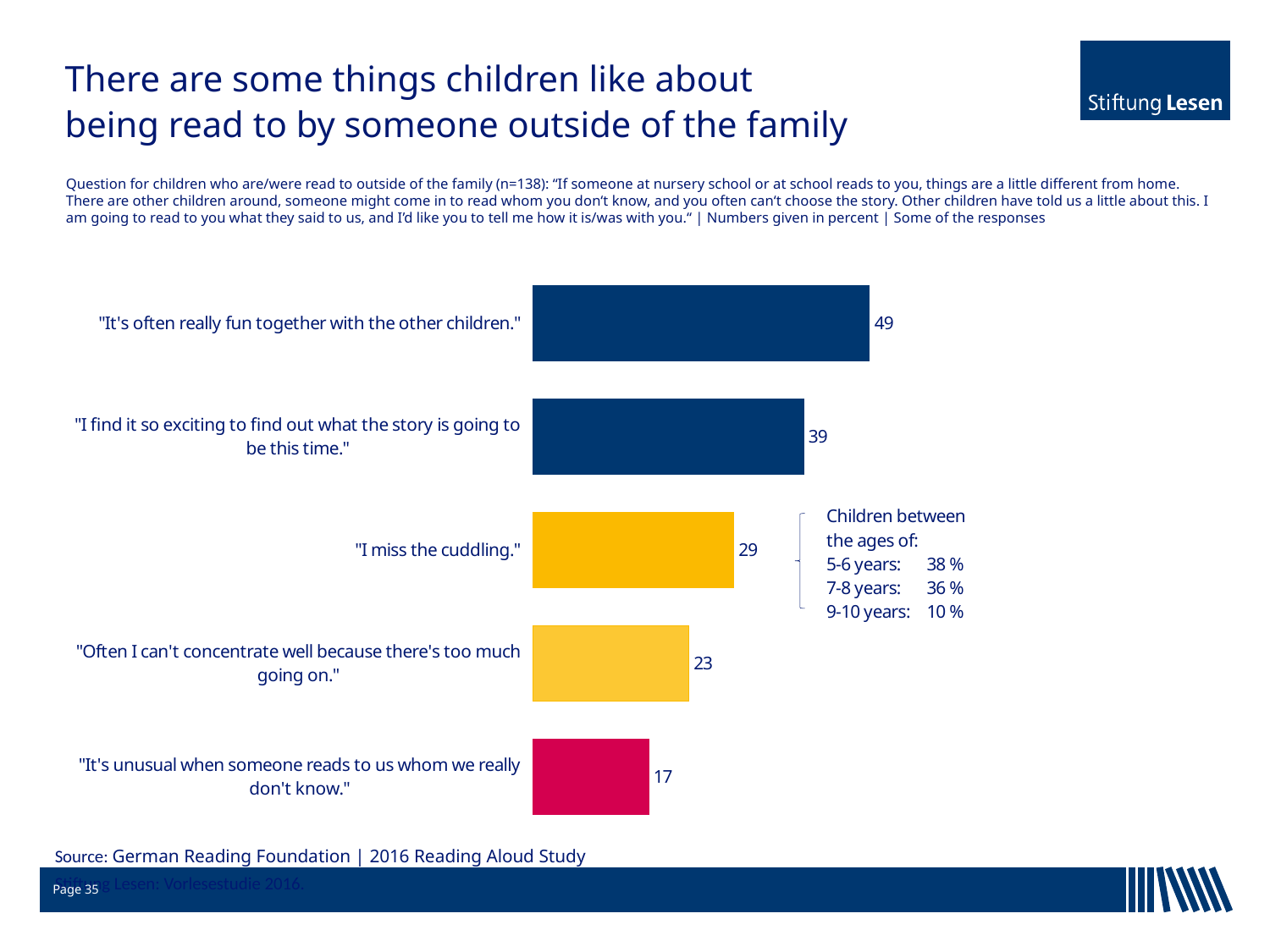
What percentage of children said "It's often really fun together with the other children."? 49 According to the annotation, what percentage of children aged 5-6 years said "I miss the cuddling."? 38 % What value is shown for "I miss the cuddling."? 29 According to the annotation, what percentage of children aged 9-10 years said "I miss the cuddling."? 10 % How many responses are shown in the chart? 5 Which response has the lowest value? "It's unusual when someone reads to us whom we really don't know." What kind of chart is shown on the slide? Bar chart Which response has the highest value? "It's often really fun together with the other children." Which is larger: the value for "I miss the cuddling." or the value for "Often I can't concentrate well because there's too much going on."? "I miss the cuddling." What colour is the bar for "It's unusual when someone reads to us whom we really don't know."? Red What value is shown for "It's unusual when someone reads to us whom we really don't know."? 17 What is the difference between the values for "It's often really fun together with the other children." and "I find it so exciting to find out what the story is going to be this time."? 10